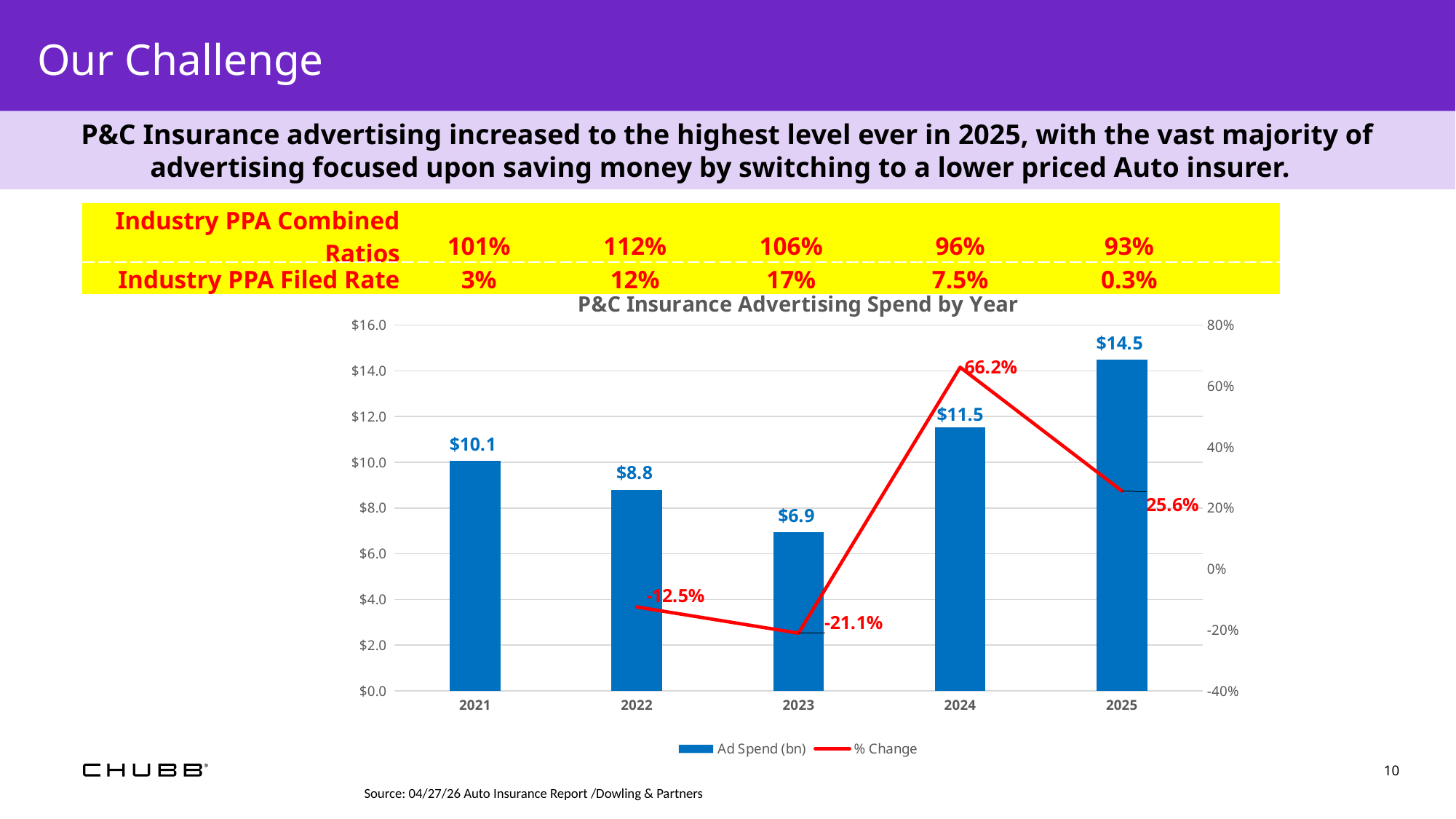
What is the % Change value for 2024? 66.2% Which year has the highest Ad Spend (bn)? 2025 What is the % Change value for 2022? -12.5% What is the Ad Spend (bn) value for 2023? $6.9 Which is larger, the Ad Spend (bn) for 2021 or for 2022? 2021 Which year has the lowest Ad Spend (bn)? 2023 How many series does the chart legend list? 2 What is the Ad Spend (bn) value for 2021? $10.1 What kind of chart is used to show Ad Spend (bn)? bar chart What is the title of the chart? P&C Insurance Advertising Spend by Year How many years are shown on the x axis of the chart? 5 What is the difference in Ad Spend (bn) between 2025 and 2024? $3.0